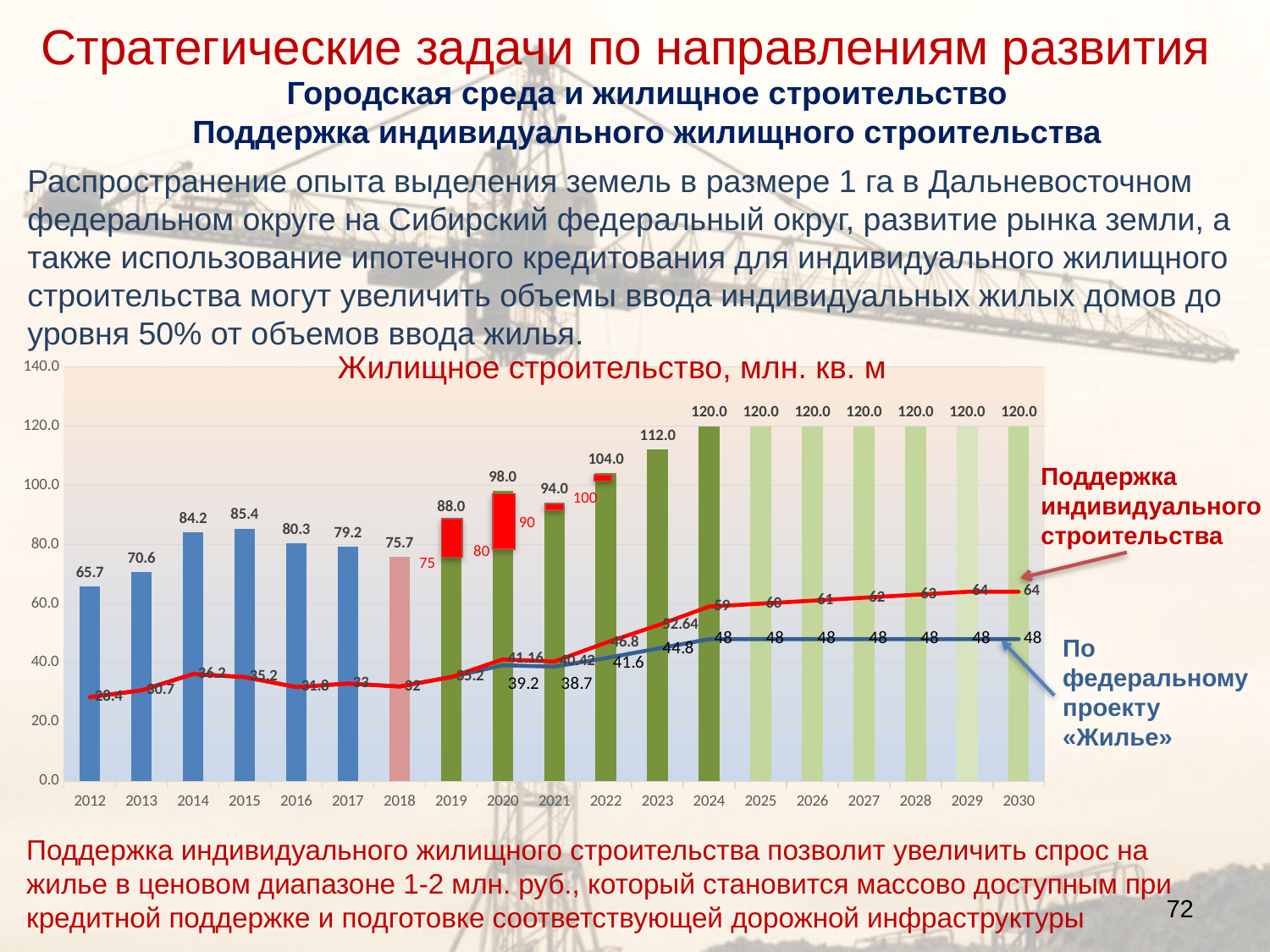
Which bar is taller, 2014 or 2016? 2014 What is the bar value for 2012? 65.7 What is the difference between the bar values for 2023 and 2022? 8.0 How many years are shown on the x axis? 19 Which year from 2012 to 2023 has the highest bar? 2023 What kind of chart is shown on the slide? bar chart (with line series) What is the value of the blue line (По федеральному проекту «Жилье») in 2030? 48 What is the bar value for 2023? 112.0 Which year has the lowest bar in the chart? 2012 What is the bar value for 2018? 75.7 What is the value of the red line (Поддержка индивидуального строительства) in 2030? 64 What is the title of the chart? Жилищное строительство, млн. кв. м